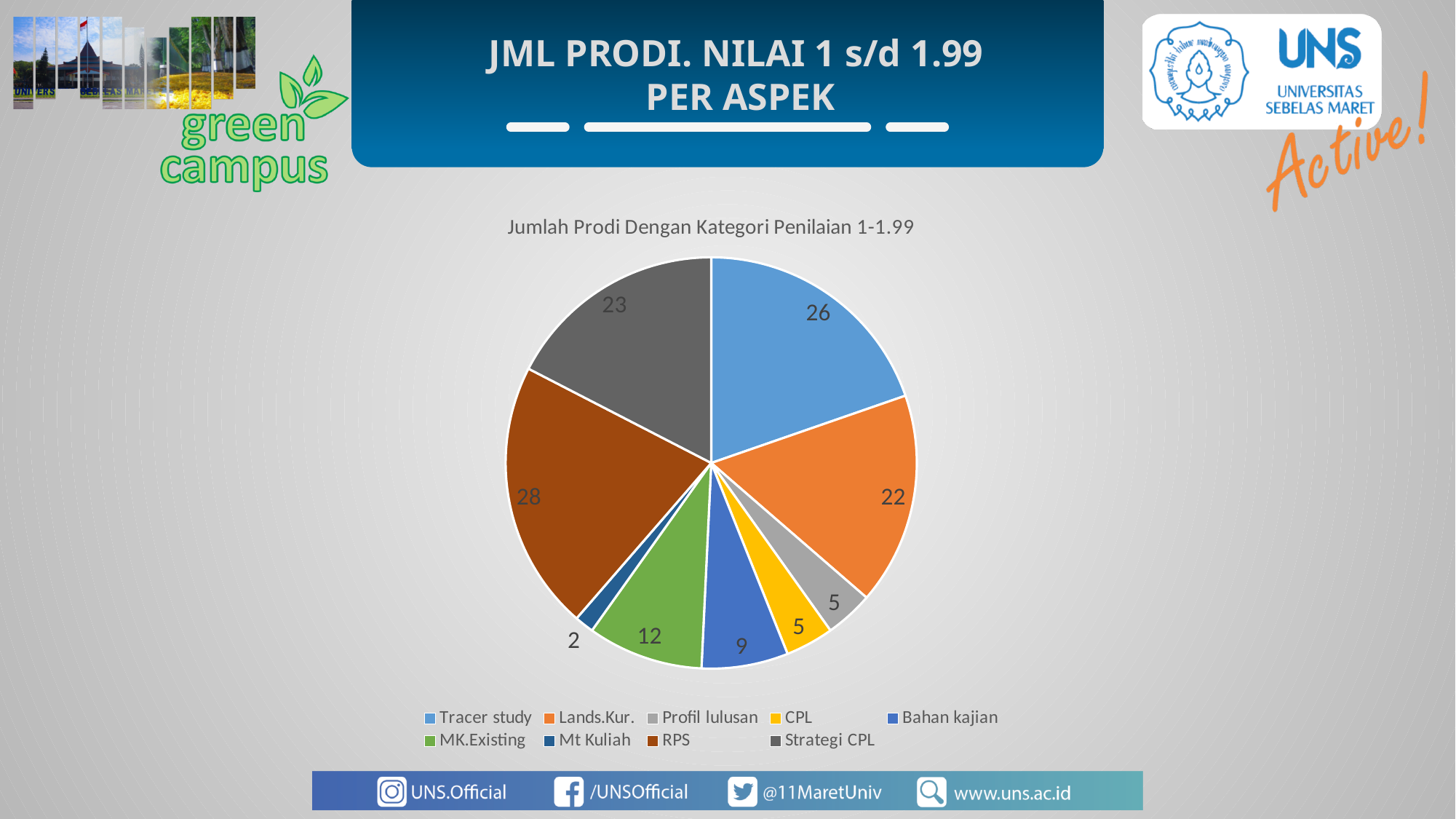
What is the value for Bahan kajian? 9 What is the value for MK.Existing? 12 Which category has the largest slice? RPS What is the total of all slices in the pie chart? 132 Which is larger, the value for Lands.Kur. or the value for Strategi CPL? Strategi CPL What is the difference between the values for RPS and Strategi CPL? 5 What type of chart is shown on the slide? Pie chart What is the title of the chart? Jumlah Prodi Dengan Kategori Penilaian 1-1.99 Which category has the smallest slice? Mt Kuliah How many categories does the pie chart have? 9 What is the value for RPS? 28 What is the value for Tracer study? 26